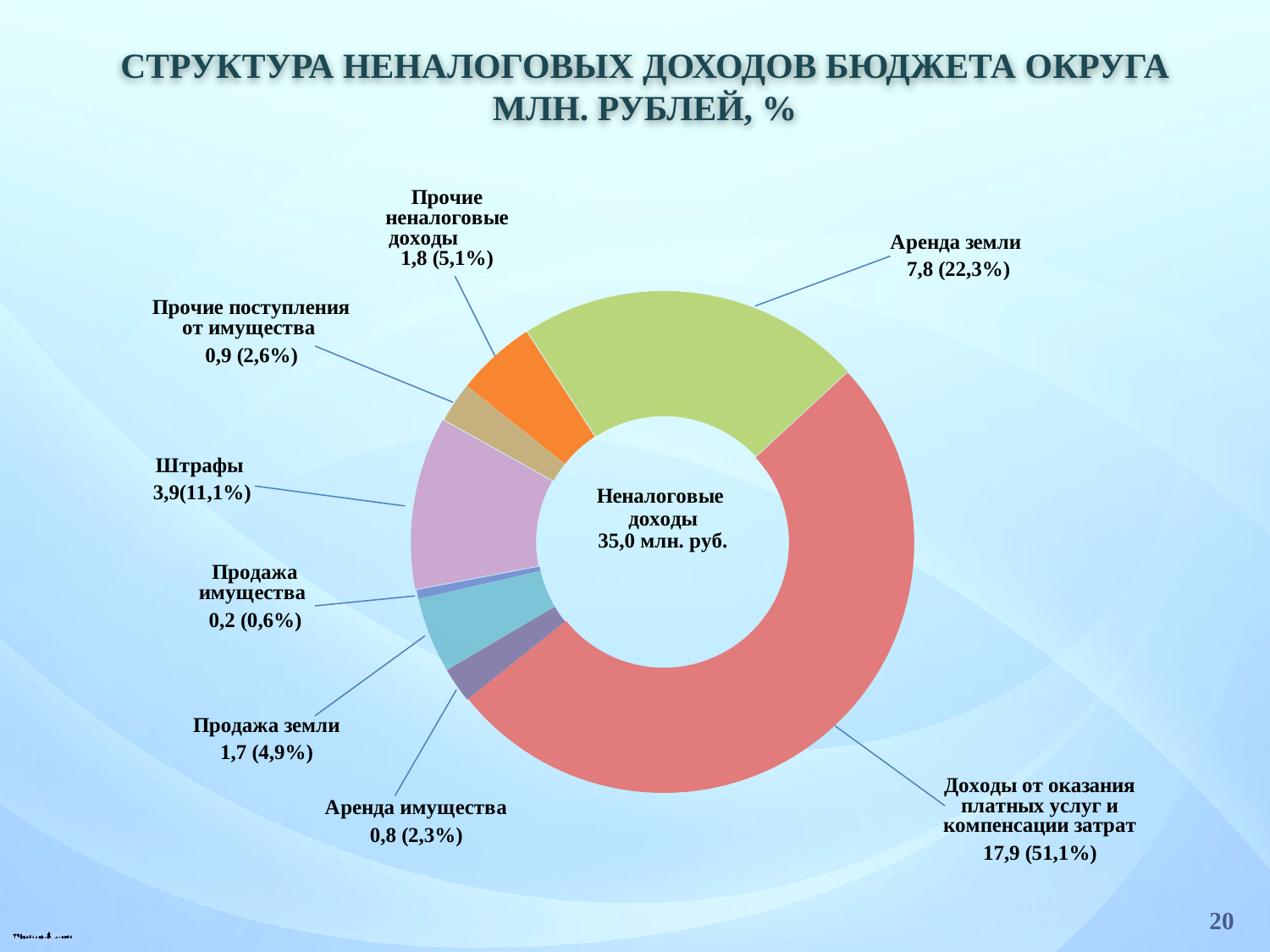
How many categories (segments) does the chart show? 8 What total value is shown in the centre of the chart? 35,0 млн. руб. Which category has the largest value? Доходы от оказания платных услуг и компенсации затрат What type of chart is shown on the slide? Doughnut (pie) chart Which is larger: «Продажа земли» or «Прочие неналоговые доходы»? Прочие неналоговые доходы What is the value for «Штрафы»? 3,9 (11,1%) What share of the total does «Доходы от оказания платных услуг и компенсации затрат» account for? 51,1% What is the value for «Аренда земли»? 7,8 (22,3%) Which category has the smallest value? Продажа имущества What is the difference in млн. рублей between «Аренда земли» and «Штрафы»? 3,9 What is the value for «Продажа имущества»? 0,2 (0,6%) What colour is the segment for «Аренда земли»? Green